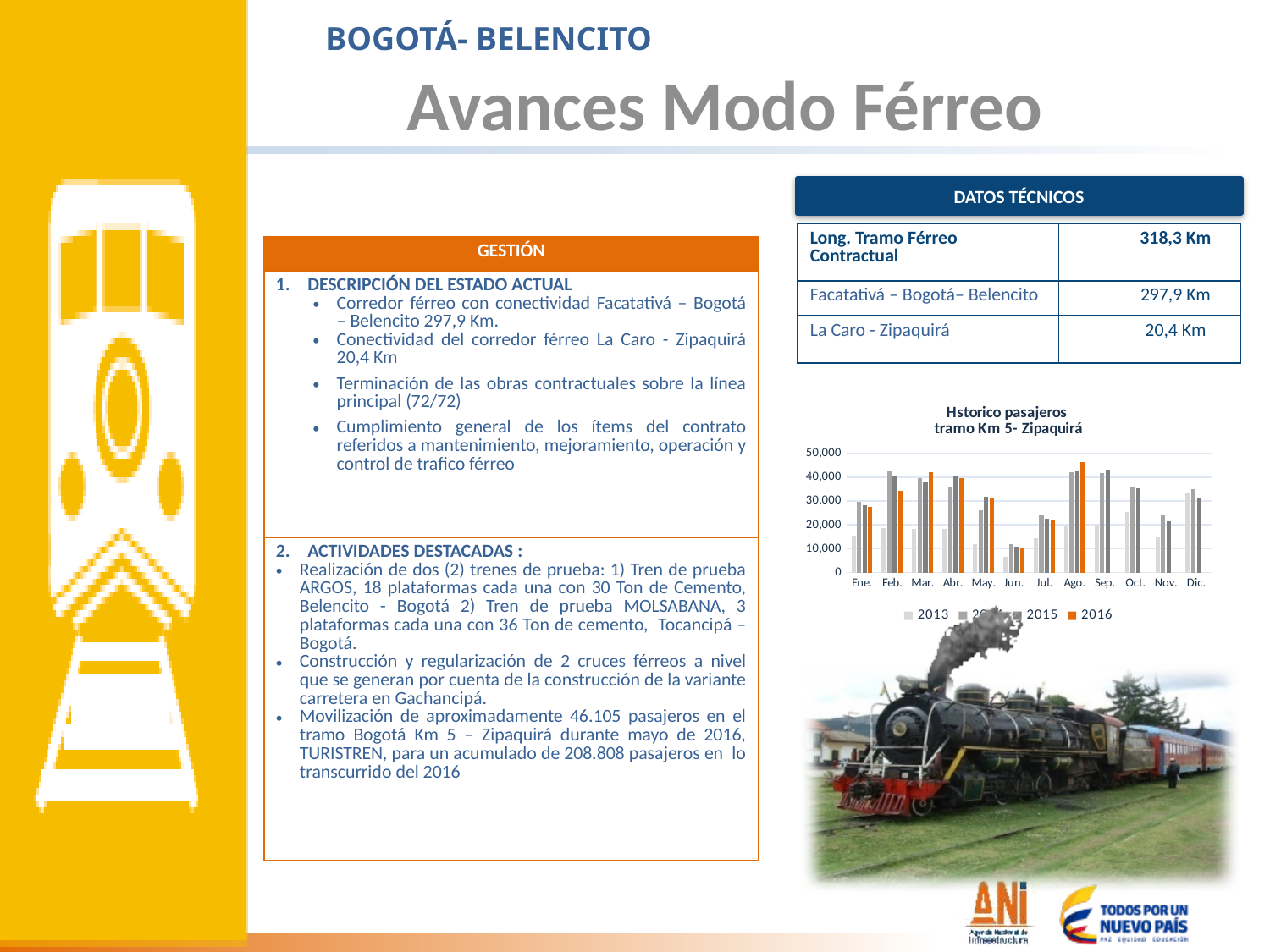
What kind of chart is shown under the title 'Hstorico pasajeros tramo Km 5- Zipaquirá'? bar chart In the 'Hstorico pasajeros' chart, is the 2016 value for Jul. greater or less than 30,000? less In the 'Hstorico pasajeros' chart, which is larger for 2016: the value for Feb. or the value for Ene.? Feb. How many series does the legend of the 'Hstorico pasajeros' chart list? 4 In the 'Hstorico pasajeros' chart, is the 2016 value for Feb. greater or less than 30,000? greater What colour are the 2016 bars in the 'Hstorico pasajeros' chart? orange In the 'Hstorico pasajeros' chart, which month has the lowest 2016 bar? Jun. In the 'Hstorico pasajeros' chart, which month has the tallest 2016 bar? Ago. In the 'Hstorico pasajeros' chart, is the 2016 value for Jun. greater or less than 20,000? less In the 'Hstorico pasajeros' chart, which is larger for 2016: the value for Ago. or the value for Jun.? Ago. How many months are shown on the x axis of the 'Hstorico pasajeros' chart? 12